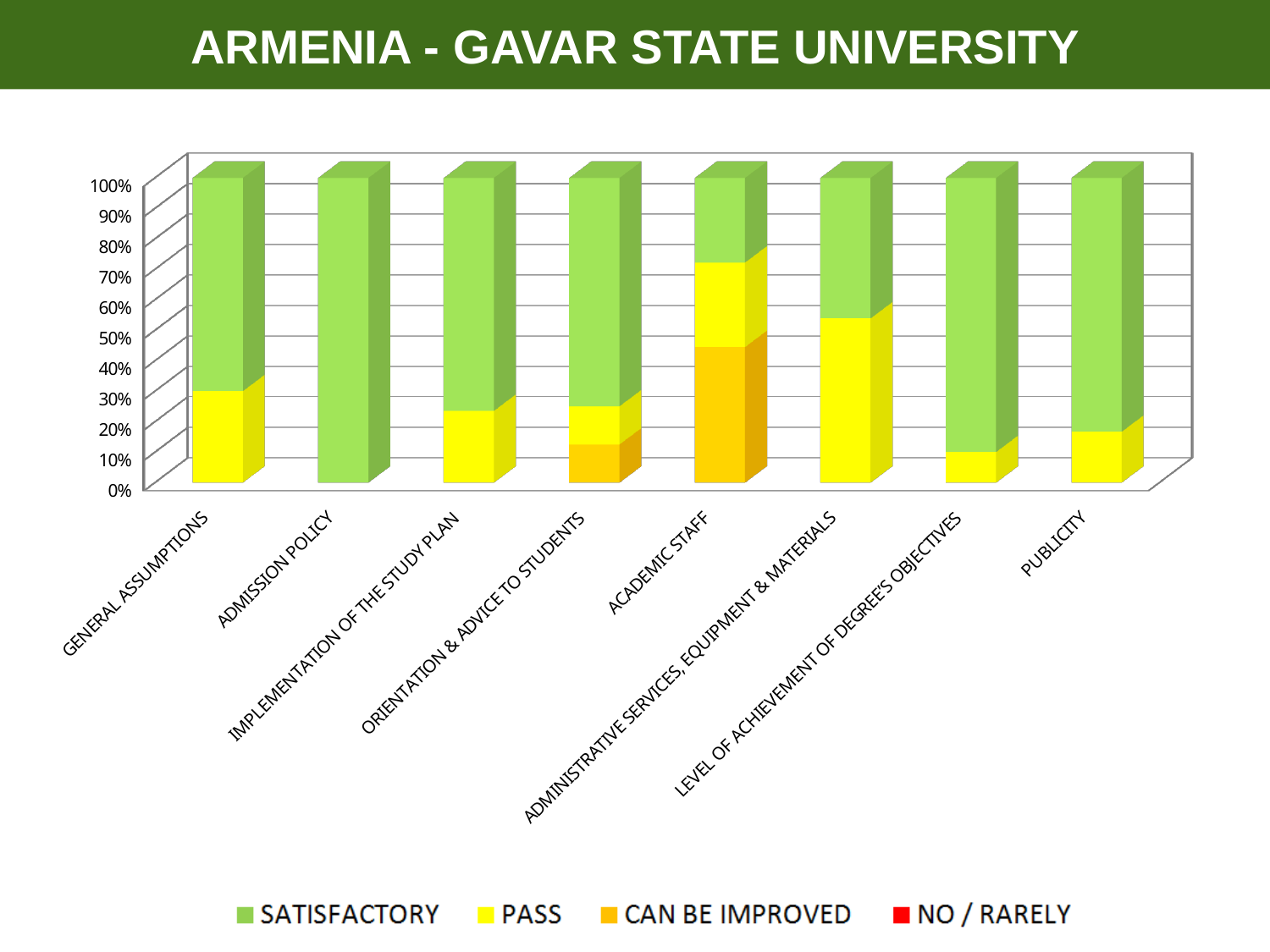
Is the CAN BE IMPROVED share for ACADEMIC STAFF greater or less than 40%? greater Which category has the largest PASS share? ADMINISTRATIVE SERVICES, EQUIPMENT & MATERIALS How many series does the legend list? 4 Is the PASS share for IMPLEMENTATION OF THE STUDY PLAN greater or less than 30%? less What kind of chart is shown on the slide? Stacked bar chart Which legend series is shown in red? NO / RARELY Is the PASS share larger for GENERAL ASSUMPTIONS or for LEVEL OF ACHIEVEMENT OF DEGREE'S OBJECTIVES? GENERAL ASSUMPTIONS Which category has the smallest SATISFACTORY share? ACADEMIC STAFF How many categories are shown along the x axis? 8 Is the SATISFACTORY share for LEVEL OF ACHIEVEMENT OF DEGREE'S OBJECTIVES greater or less than 80%? greater Which category has the largest CAN BE IMPROVED share? ACADEMIC STAFF Which category has the largest SATISFACTORY share? ADMISSION POLICY